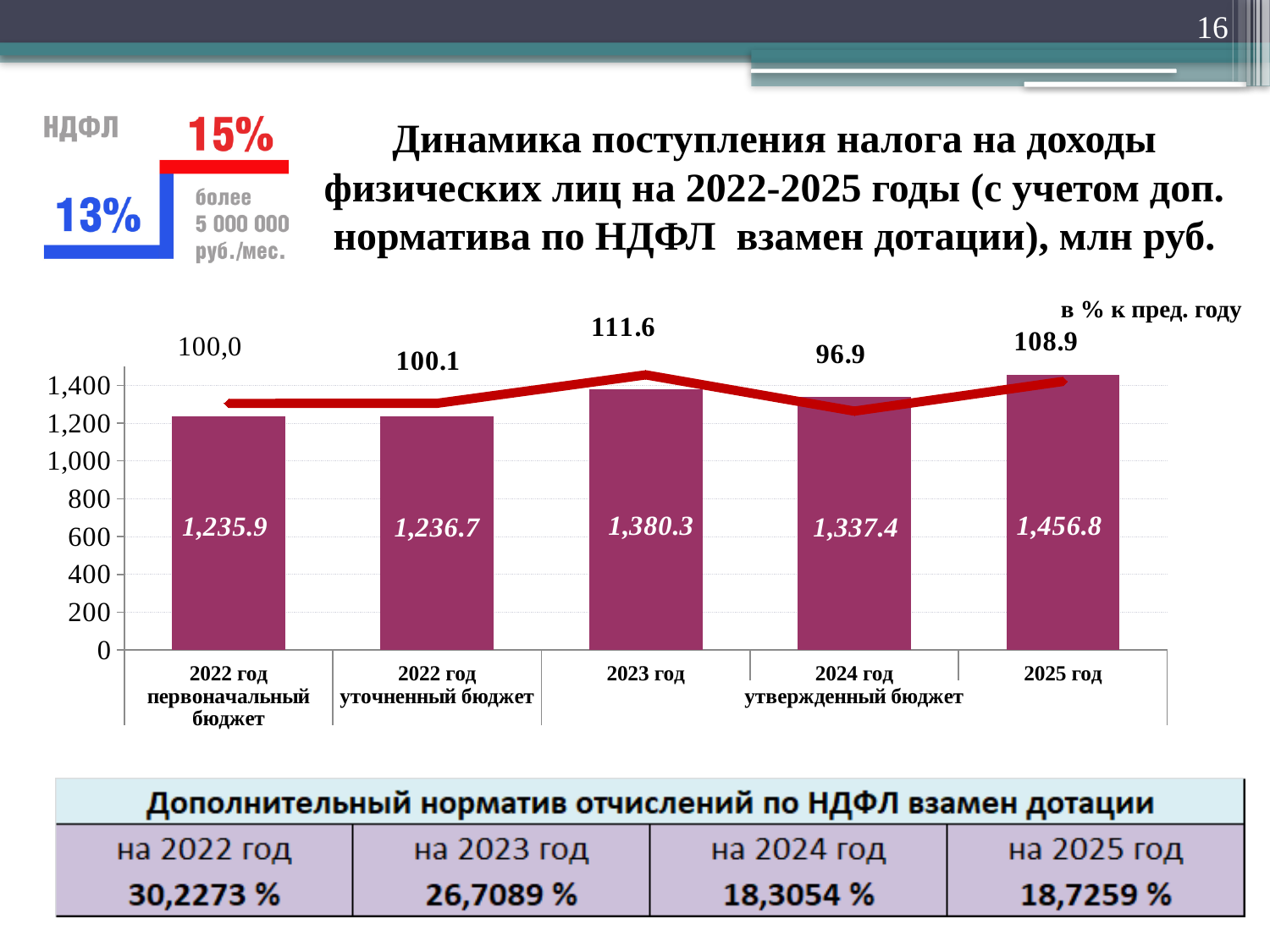
What is the difference between the bar values for 2025 год and 2024 год утвержденный бюджет? 119.4 What is the value of the bar for 2023 год? 1,380.3 What is the value of the bar for 2022 год уточненный бюджет? 1,236.7 What is the value of the bar for 2025 год? 1,456.8 Which category has the highest bar value? 2025 год How many bars are shown in the chart? 5 Which bar is larger: 2023 год or 2024 год утвержденный бюджет? 2023 год Which category has the lowest bar value? 2022 год первоначальный бюджет What is the value of the line (в % к пред. году) for 2024 год утвержденный бюджет? 96.9 What is the value of the line (в % к пред. году) for 2023 год? 111.6 What is the unit of measurement stated in the chart title? млн руб. Which category has the lowest value on the line (в % к пред. году)? 2024 год утвержденный бюджет